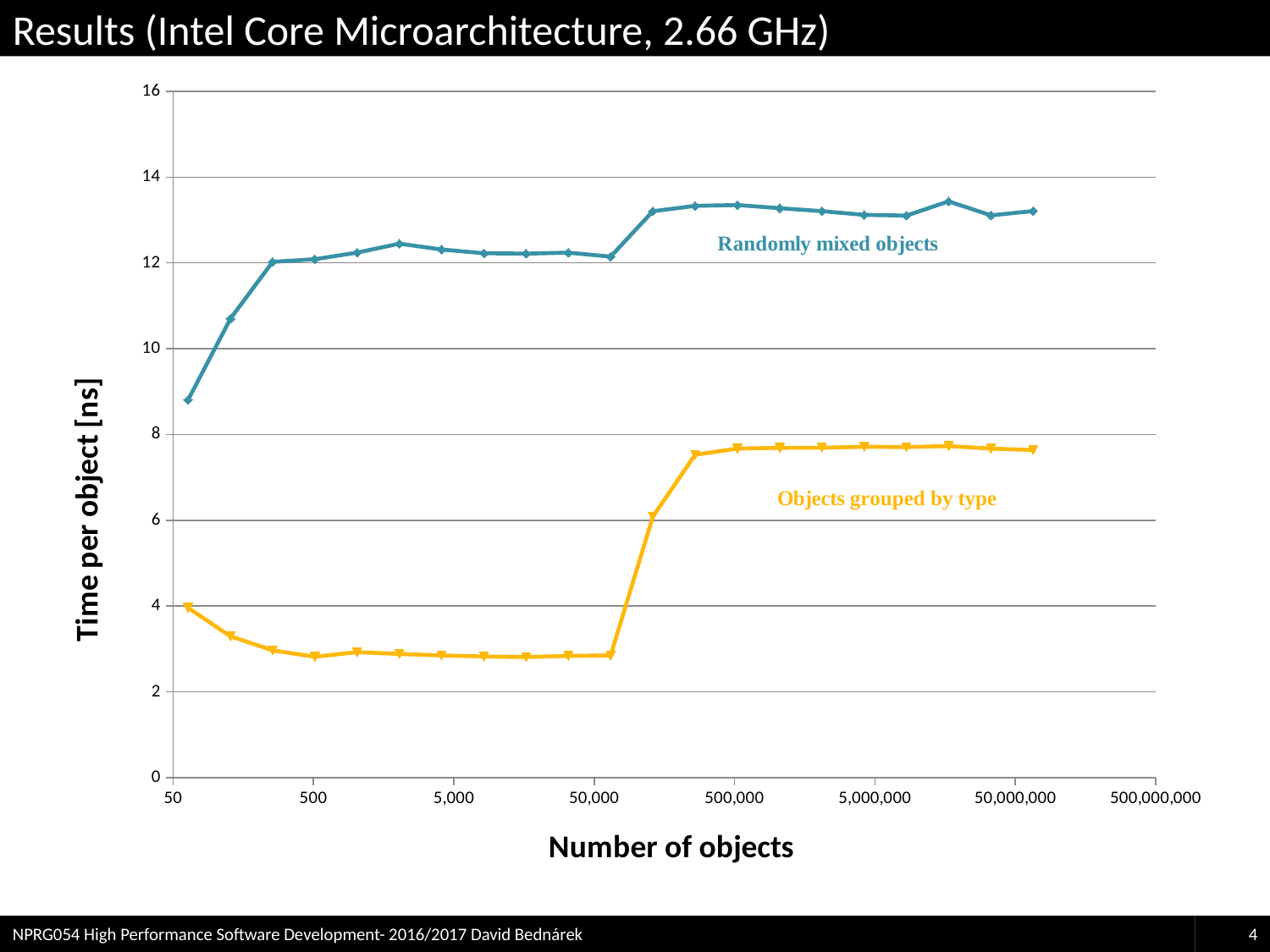
How many data series are plotted on the chart? 2 Is the value for Objects grouped by type at 500 objects greater or less than 4? less What kind of chart is shown on the slide? line chart Is the value for Randomly mixed objects at 50 objects greater or less than 8? greater Does the Objects grouped by type series rise or fall between 50,000 and 500,000 objects? rise Is the value for Objects grouped by type at 50,000 objects greater or less than 4? less What is the label of the vertical axis? Time per object [ns] Does the Randomly mixed objects series rise or fall between 50 and 500 objects? rise What are the names of the two series plotted on the chart? Randomly mixed objects; Objects grouped by type At 500,000 objects, which series has the higher time per object: Randomly mixed objects or Objects grouped by type? Randomly mixed objects